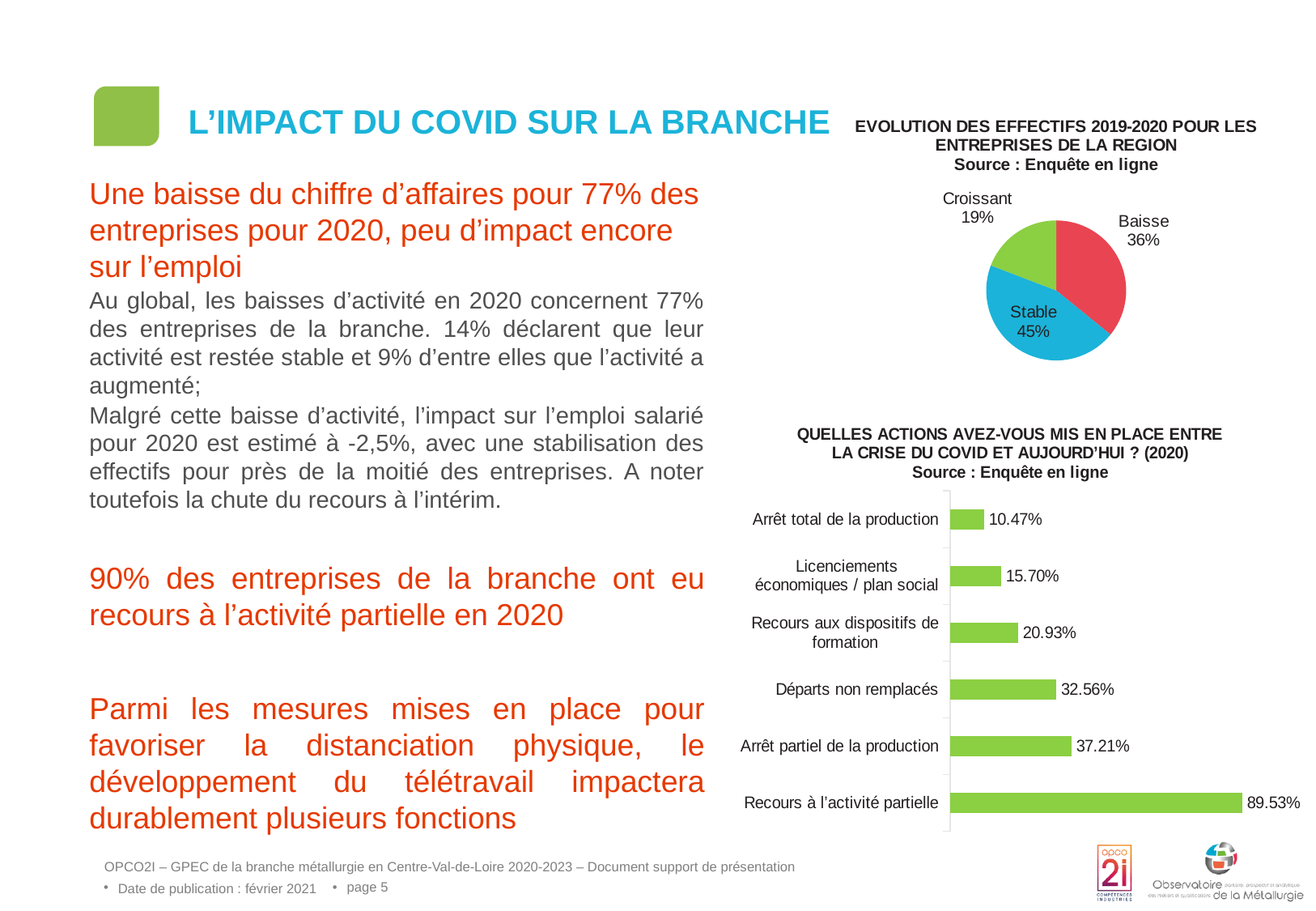
In the pie chart 'Evolution des effectifs 2019-2020 pour les entreprises de la région', what is the difference between the 'Baisse' and 'Croissant' shares? 17% In the bar chart 'Quelles actions avez-vous mis en place entre la crise du Covid et aujourd'hui ? (2020)', which is larger: 'Arrêt partiel de la production' or 'Recours aux dispositifs de formation'? Arrêt partiel de la production In the bar chart 'Quelles actions avez-vous mis en place entre la crise du Covid et aujourd'hui ? (2020)', which action has the lowest value? Arrêt total de la production In the bar chart 'Quelles actions avez-vous mis en place entre la crise du Covid et aujourd'hui ? (2020)', what is the value for 'Recours à l'activité partielle'? 89.53% In the bar chart 'Quelles actions avez-vous mis en place entre la crise du Covid et aujourd'hui ? (2020)', what is the value for 'Départs non remplacés'? 32.56% What type of chart is 'Quelles actions avez-vous mis en place entre la crise du Covid et aujourd'hui ? (2020)'? Bar chart In the pie chart 'Evolution des effectifs 2019-2020 pour les entreprises de la région', which category has the largest share? Stable In the pie chart 'Evolution des effectifs 2019-2020 pour les entreprises de la région', how many slices are there? 3 In the pie chart 'Evolution des effectifs 2019-2020 pour les entreprises de la région', what share is labelled 'Stable'? 45% In the pie chart 'Evolution des effectifs 2019-2020 pour les entreprises de la région', which category has the smallest share? Croissant In the bar chart 'Quelles actions avez-vous mis en place entre la crise du Covid et aujourd'hui ? (2020)', how many actions are listed? 6 In the pie chart 'Evolution des effectifs 2019-2020 pour les entreprises de la région', what share is labelled 'Croissant'? 19%